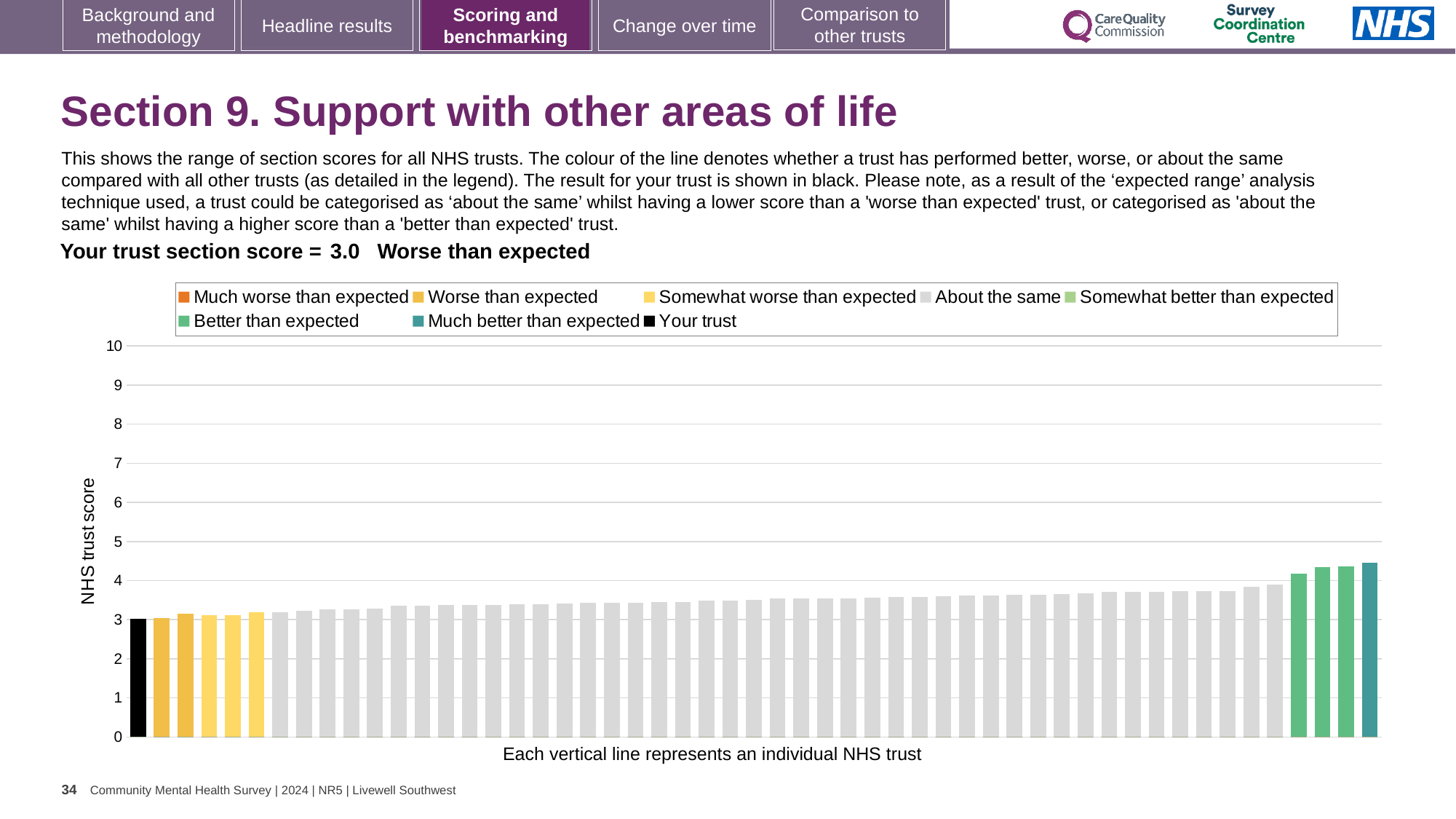
Is the value of the tallest bar (the rightmost, teal bar) greater or less than 4? greater Do the bar values rise or fall from left to right across the chart? rise Is the value of the tallest bar greater or less than 5? less What is the highest value shown on the vertical axis? 10 What is the section score for your trust shown on the slide? 3.0 How many entries does the chart legend list? 8 Which is larger, the leftmost bar or the rightmost bar? the rightmost bar Which category does the slide say your trust's section score falls into? Worse than expected Is the value of the black 'Your trust' bar greater or less than 4? less What kind of chart is shown on the slide? bar chart Which bar in the chart is the lowest? the black 'Your trust' bar (leftmost) What is the label on the vertical axis of the chart? NHS trust score